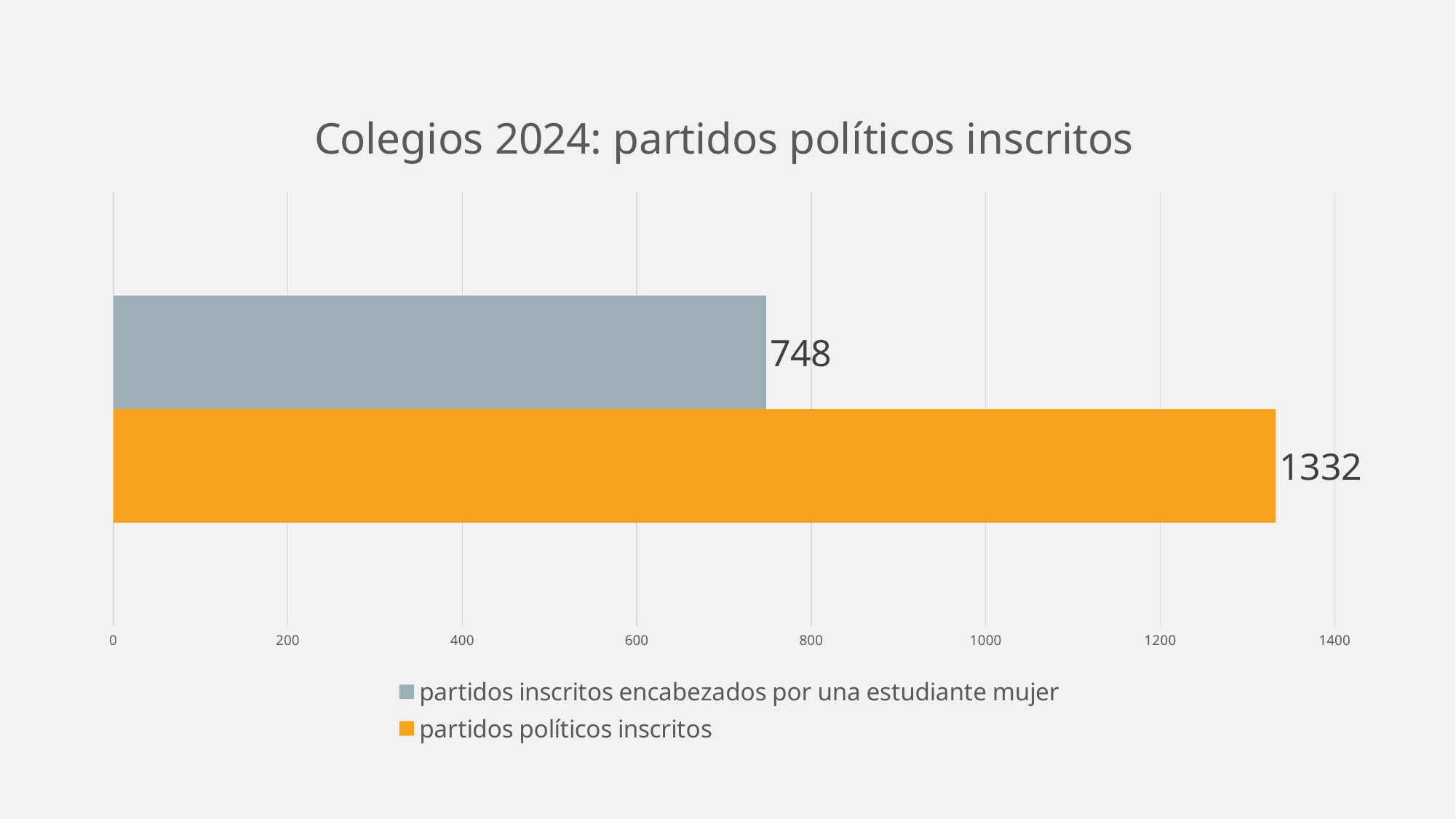
Is the value for 'partidos políticos inscritos' greater or less than 1200? greater What is the title of the chart? Colegios 2024: partidos políticos inscritos What is the difference between 'partidos políticos inscritos' and 'partidos inscritos encabezados por una estudiante mujer'? 584 Is the value for 'partidos inscritos encabezados por una estudiante mujer' larger or smaller than the value for 'partidos políticos inscritos'? smaller What is the value for 'partidos políticos inscritos'? 1332 Which series has the higher value? partidos políticos inscritos How many series does the legend list? 2 Is the value for 'partidos inscritos encabezados por una estudiante mujer' greater or less than 800? less What is the value for 'partidos inscritos encabezados por una estudiante mujer'? 748 What colour is the bar for 'partidos políticos inscritos'? orange Which series has the lower value? partidos inscritos encabezados por una estudiante mujer What kind of chart is shown on the slide? bar chart